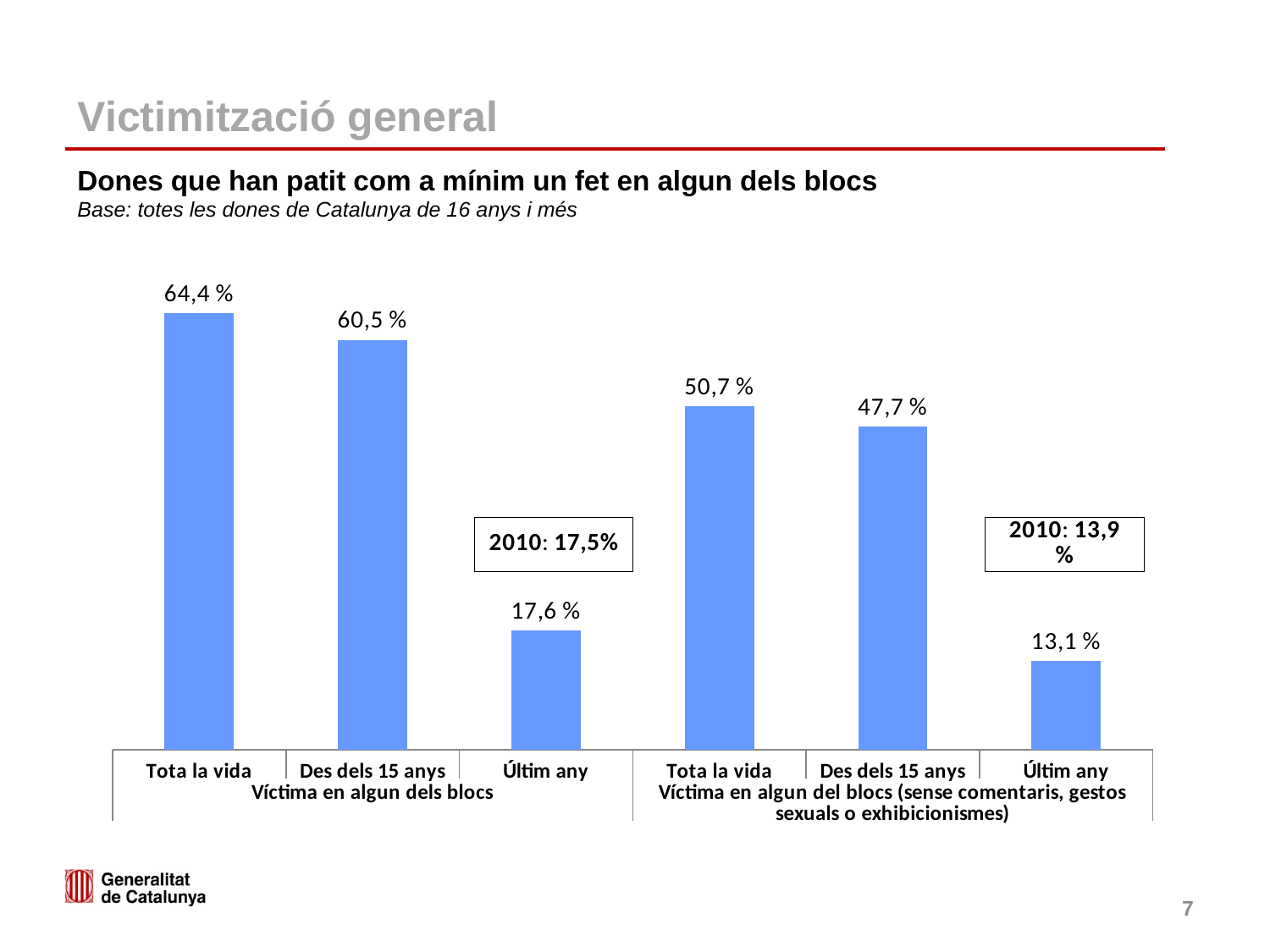
What 2010 value is shown in the box above the "Últim any" bar of the "Víctima en algun dels blocs" group? 17,5% What is the value for "Últim any" in the "Víctima en algun del blocs (sense comentaris, gestos sexuals o exhibicionismes)" group? 13,1 % What is the difference between "Tota la vida" and "Des dels 15 anys" in the "Víctima en algun dels blocs" group? 3,9 % Which is larger: "Tota la vida" in the "Víctima en algun dels blocs" group or "Tota la vida" in the "Víctima en algun del blocs (sense comentaris, gestos sexuals o exhibicionismes)" group? Víctima en algun dels blocs (64,4 %) What kind of chart is shown on the slide? Bar chart What is the base stated under the chart heading? Totes les dones de Catalunya de 16 anys i més What is the value for "Tota la vida" in the "Víctima en algun dels blocs" group? 64,4 % Which bar has the lowest value on the chart? Últim any (Víctima en algun del blocs sense comentaris, gestos sexuals o exhibicionismes) What is the difference between the "Últim any" values of the two groups? 4,5 % Which bar has the highest value on the chart? Tota la vida (Víctima en algun dels blocs) What is the value for "Des dels 15 anys" in the "Víctima en algun del blocs (sense comentaris, gestos sexuals o exhibicionismes)" group? 47,7 % How many bars are plotted on the chart? 6